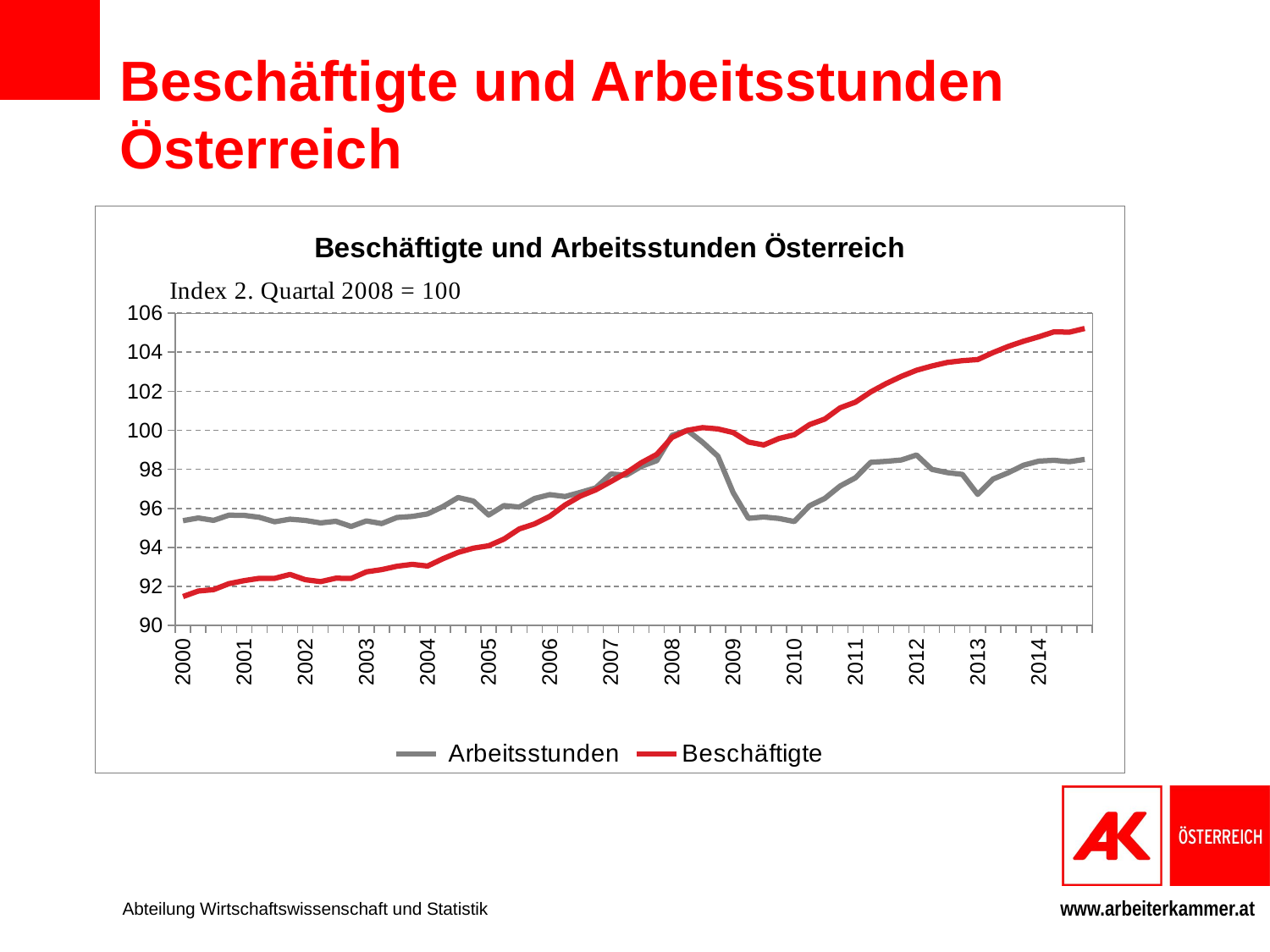
At the end of 2014, which series has the higher value, Arbeitsstunden or Beschäftigte? Beschäftigte How many years are labelled on the x axis? 15 Does the Beschäftigte line rise or fall overall from 2000 to 2014? rise How many series does the legend list? 2 Which base period is the index set to 100? 2. Quartal 2008 Is the value of Arbeitsstunden at the start of 2000 greater or less than 94? greater What kind of chart is shown on the slide? line chart Is the value of Arbeitsstunden at the end of 2014 greater or less than 100? less What are the two series named in the legend? Arbeitsstunden and Beschäftigte Is the value of Beschäftigte at the end of 2014 greater or less than 104? greater At the start of 2000, which series has the higher value, Arbeitsstunden or Beschäftigte? Arbeitsstunden